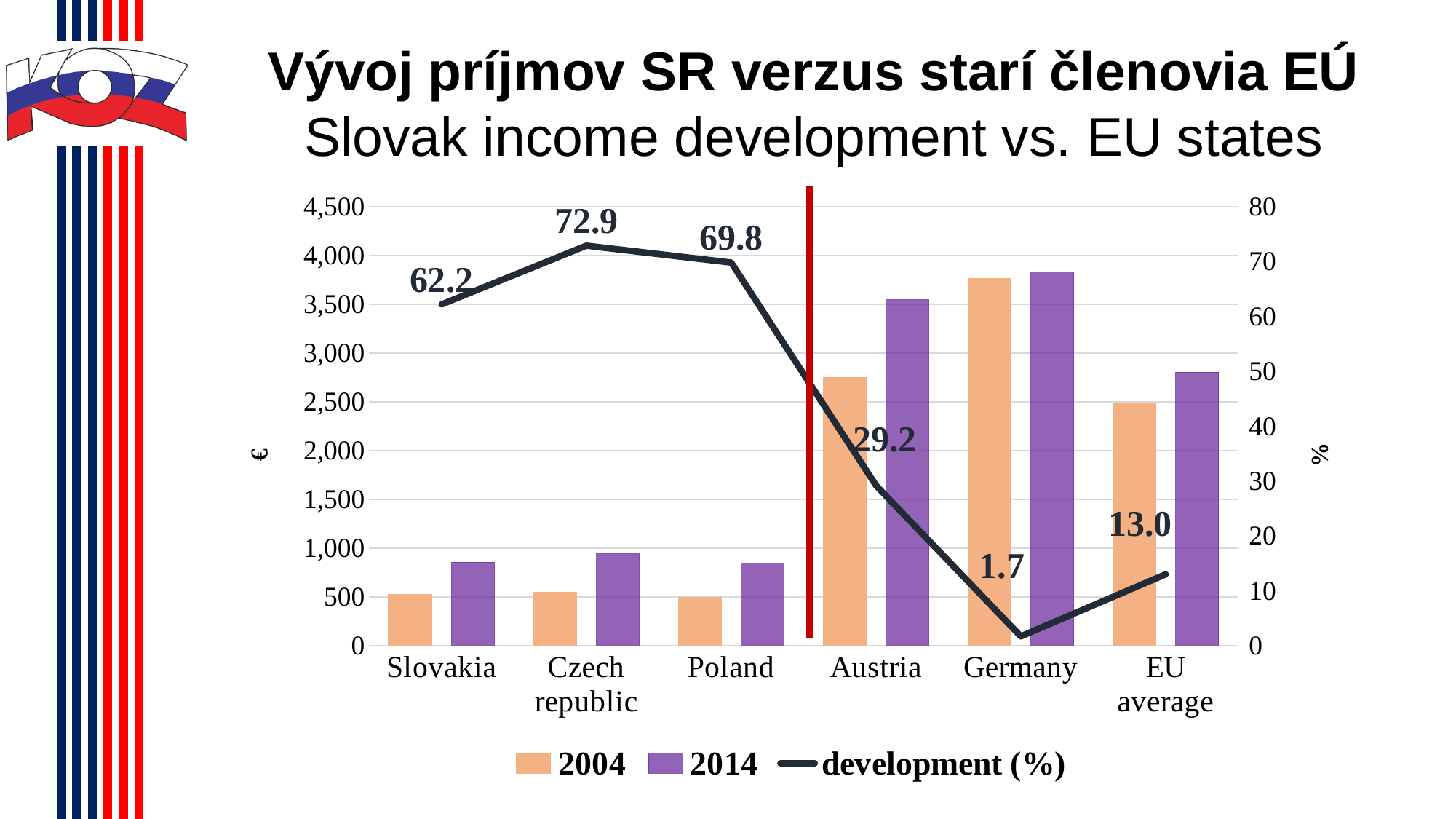
Which category has the lowest development (%) value? Germany Does the development (%) line rise or fall from Poland to Germany? fall Is the 2014 value for Germany greater or less than 3,500? greater What is the development (%) value for the EU average? 13.0 How many countries or categories are shown on the x axis? 6 What is the development (%) value for the Czech republic? 72.9 Is the 2004 value for Slovakia greater or less than 1,000? less Which has a larger development (%) value, Austria or the EU average? Austria Which category has the highest development (%) value? Czech republic What is the development (%) value for Germany? 1.7 How many series does the legend list? 3 What is the difference between the development (%) values for the Czech republic and Poland? 3.1